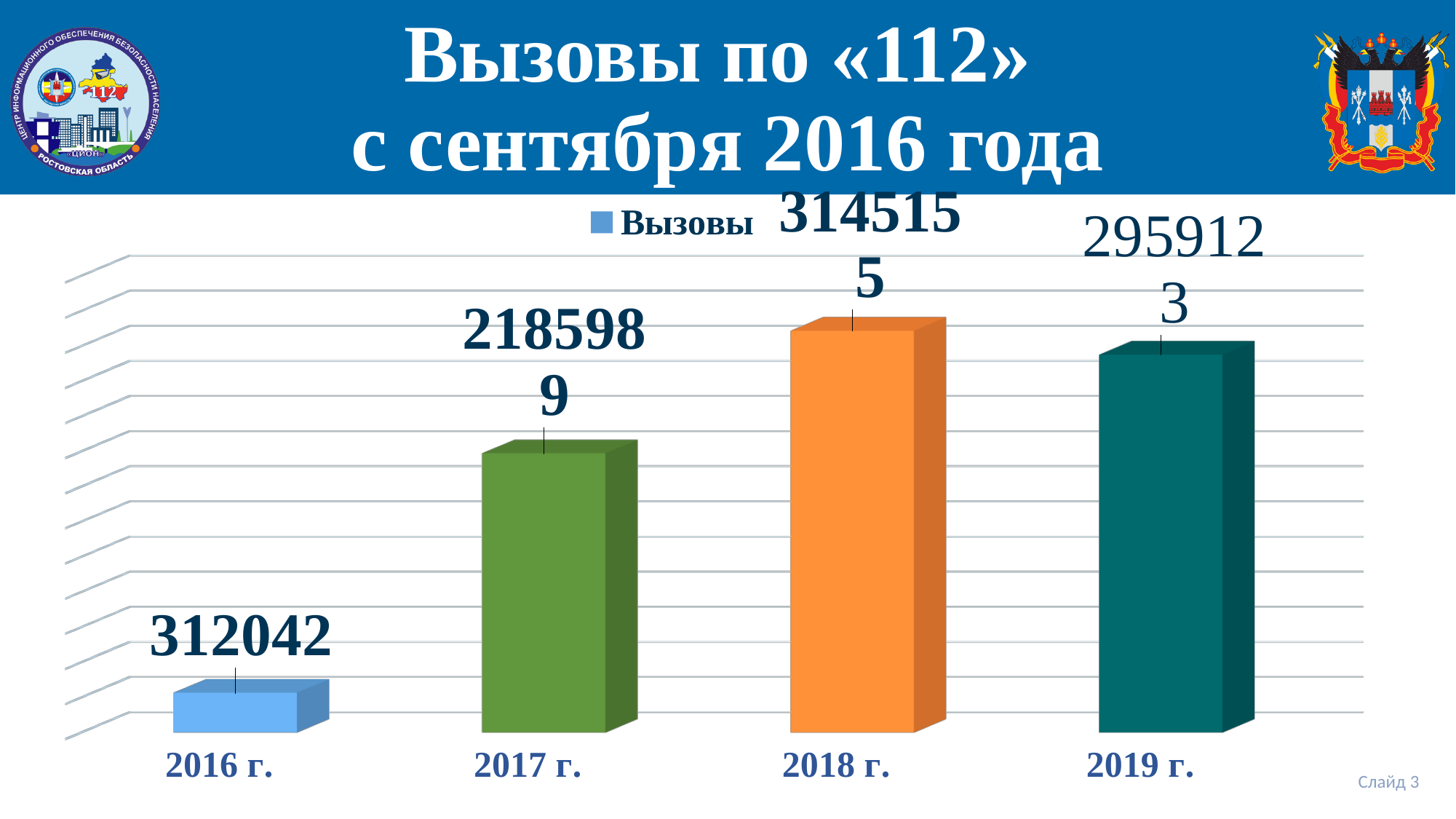
What is the value for 2018 г.? 3145155 What is the difference between the values for 2018 г. and 2019 г.? 186032 What is the value for 2019 г.? 2959123 Which year has the lowest value? 2016 г. What is the difference between the values for 2017 г. and 2016 г.? 1873947 Which year has the highest value? 2018 г. What is the value for 2017 г.? 2185989 Which is larger, the value for 2017 г. or the value for 2019 г.? 2019 г. How many years are shown on the x axis? 4 What kind of chart is shown on the slide? bar chart What is the value for 2016 г.? 312042 What is the name of the series listed in the legend? Вызовы